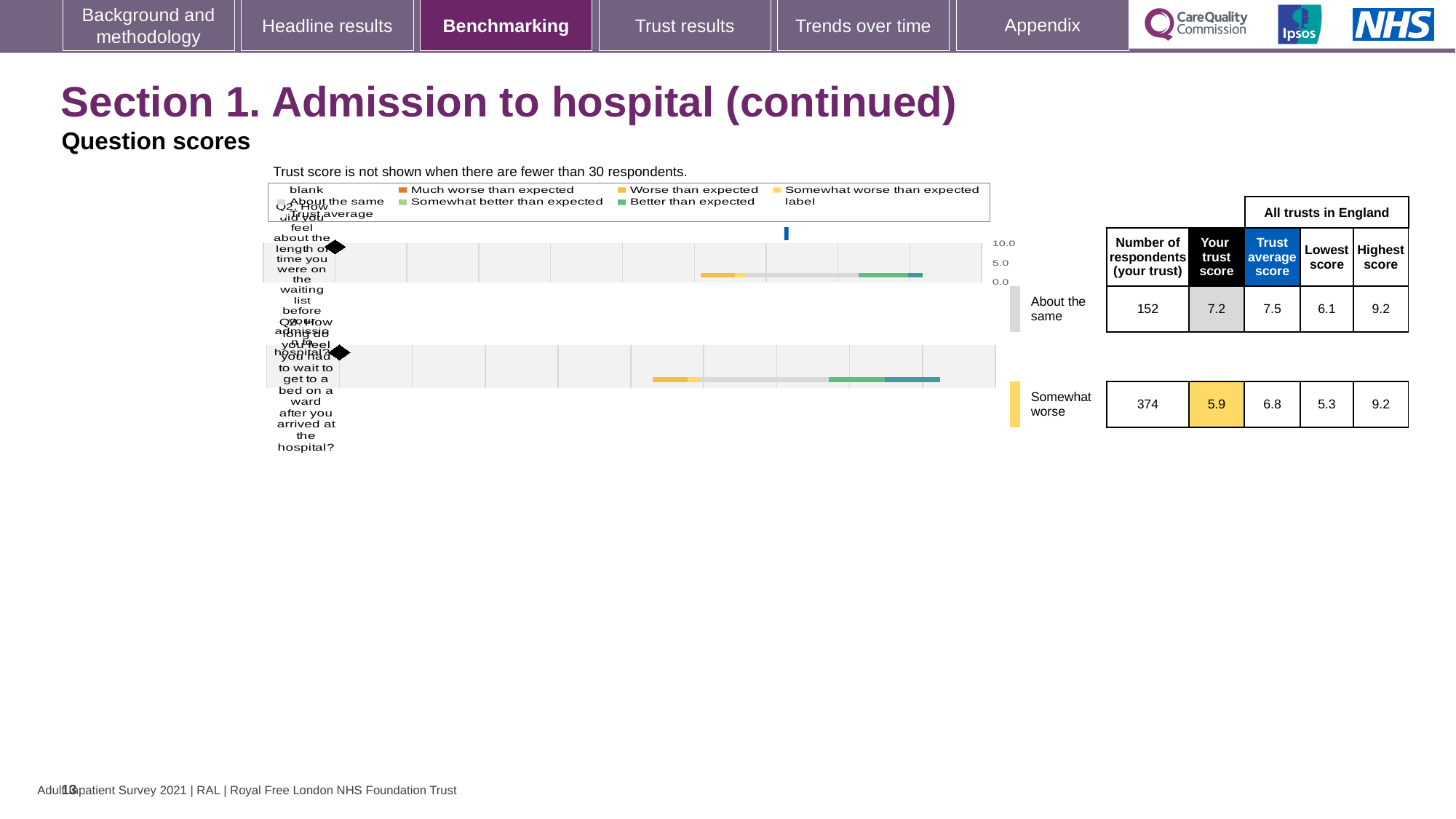
What is the difference between the trust scores for Q2 and Q3? 1.3 How many survey questions are charted on the slide? 2 What is the trust average score for all trusts in England for Q3? 6.8 What is the lowest score across all trusts in England for Q3? 5.3 What is the maximum value shown on the chart's score axis? 10.0 What benchmark category is the trust's Q3 score placed in? Somewhat worse How many respondents from the trust answered Q2? 152 What is the trust score for Q3 (wait to get to a bed on a ward after arriving at the hospital)? 5.9 Which question has the higher trust score, Q2 or Q3? Q2 What kind of chart is used to show the question scores for Q2 and Q3? bar chart What is the highest score across all trusts in England for Q2? 9.2 What is the trust score for Q2 (length of time on the waiting list before admission)? 7.2